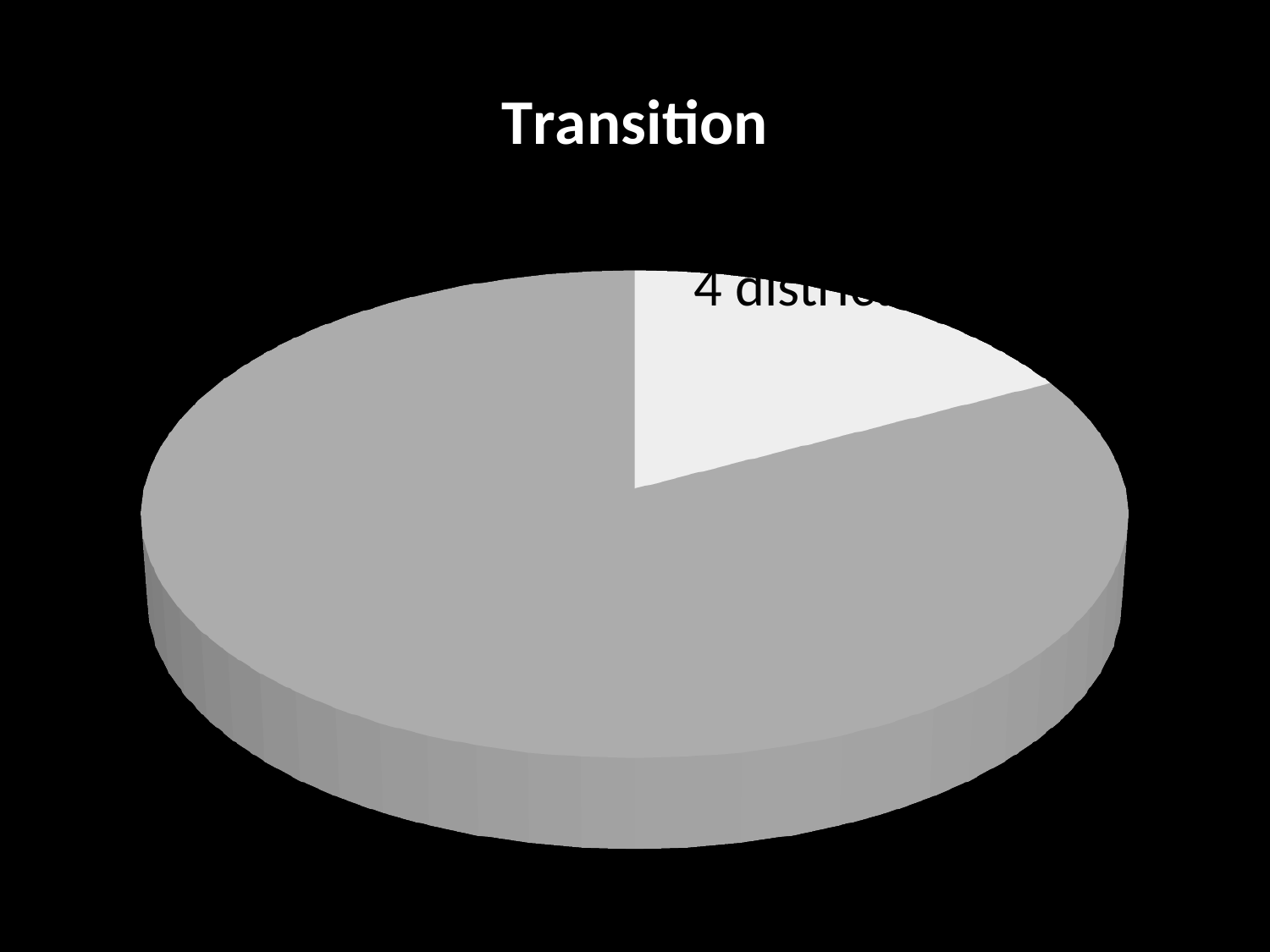
What is the title of the chart? Transition What kind of chart is shown on the slide? pie chart Which slice is larger, the grey slice or the white slice? the grey slice How many slices does the pie chart have? 2 What colour is the largest slice of the pie chart? grey